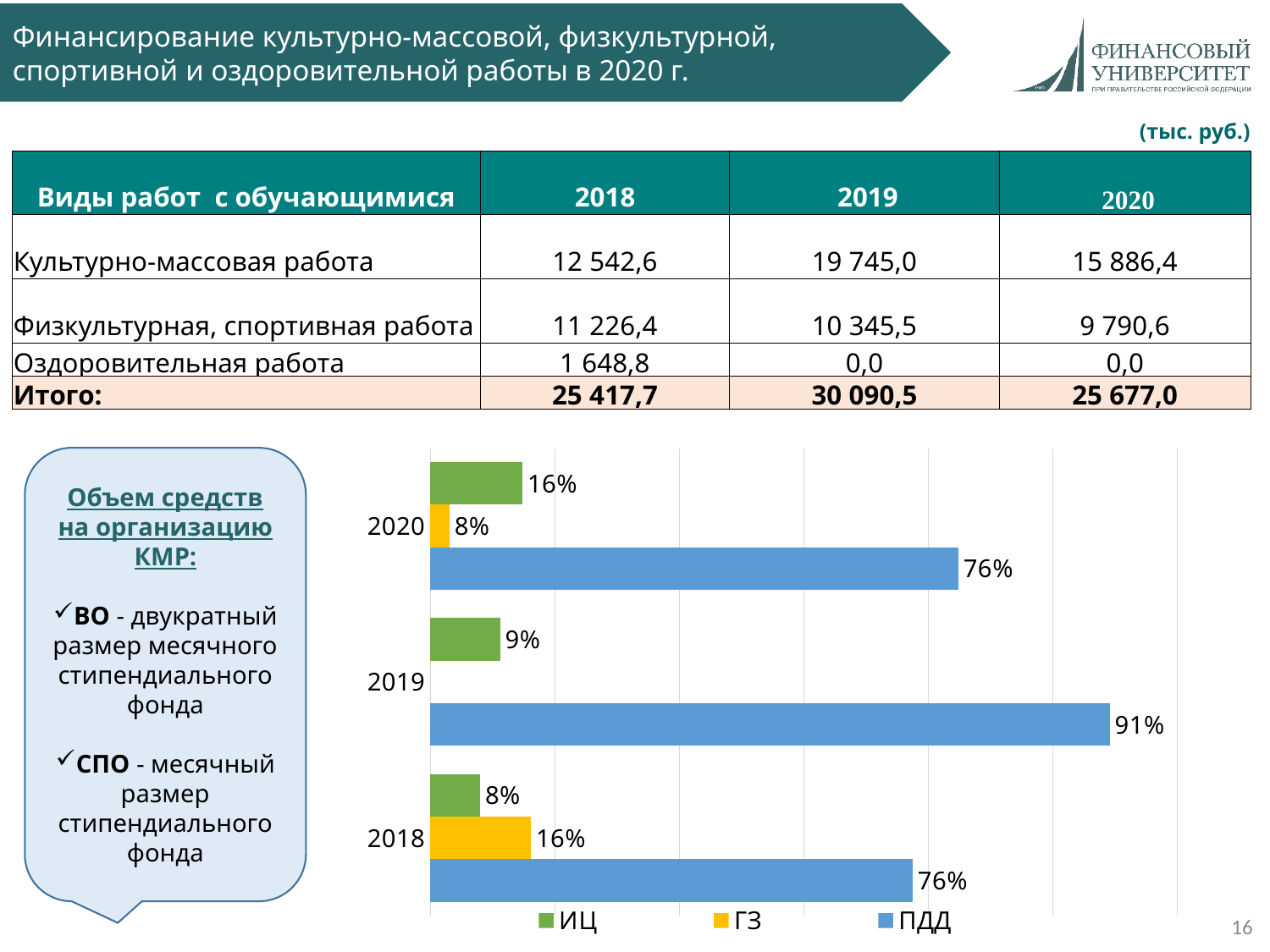
What is the difference between the ПДД value for 2019 and the ПДД value for 2020? 15% In which year is the ИЦ value lowest in the chart? 2018 How many year categories are shown on the chart? 3 What type of chart is shown on the slide? bar chart How many series does the chart legend list? 3 In which year is the ПДД value highest in the chart? 2019 What is the value of ГЗ for 2018 in the chart? 16% What is the value of ИЦ for 2019 in the chart? 9% Which is larger in the chart: ГЗ for 2018 or ГЗ for 2020? ГЗ for 2018 What is the value of ИЦ for 2020 in the chart? 16% Which series in the chart is shown in blue? ПДД What is the value of ПДД for 2019 in the chart? 91%